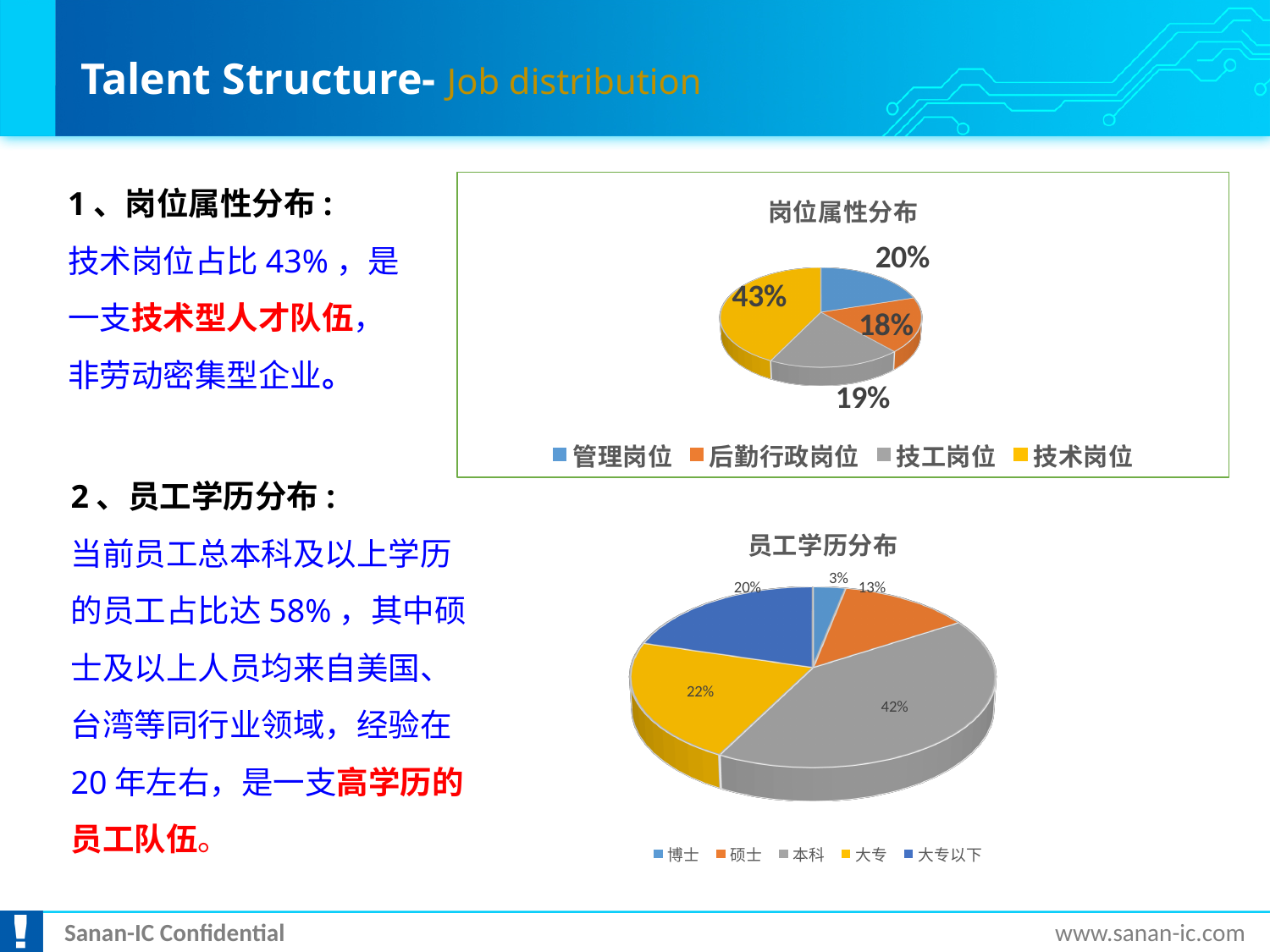
How many categories does the legend of the 员工学历分布 chart list? 5 In the 岗位属性分布 chart, what is the difference between the shares of 技术岗位 and 管理岗位? 23% In the 员工学历分布 chart, which category has the smallest share? 博士 What kind of chart is the 员工学历分布 chart? pie chart In the 岗位属性分布 chart, which category has the smallest share? 后勤行政岗位 In the 员工学历分布 chart, what share does 博士 have? 3% In the 员工学历分布 chart, which is larger, the share of 大专 or the share of 硕士? 大专 In the 员工学历分布 chart, what share does 本科 have? 42% In the 岗位属性分布 chart, what share does 技术岗位 have? 43% How many categories does the 岗位属性分布 chart show? 4 In the 岗位属性分布 chart, which category has the largest share? 技术岗位 In the 岗位属性分布 chart, what share does 后勤行政岗位 have? 18%